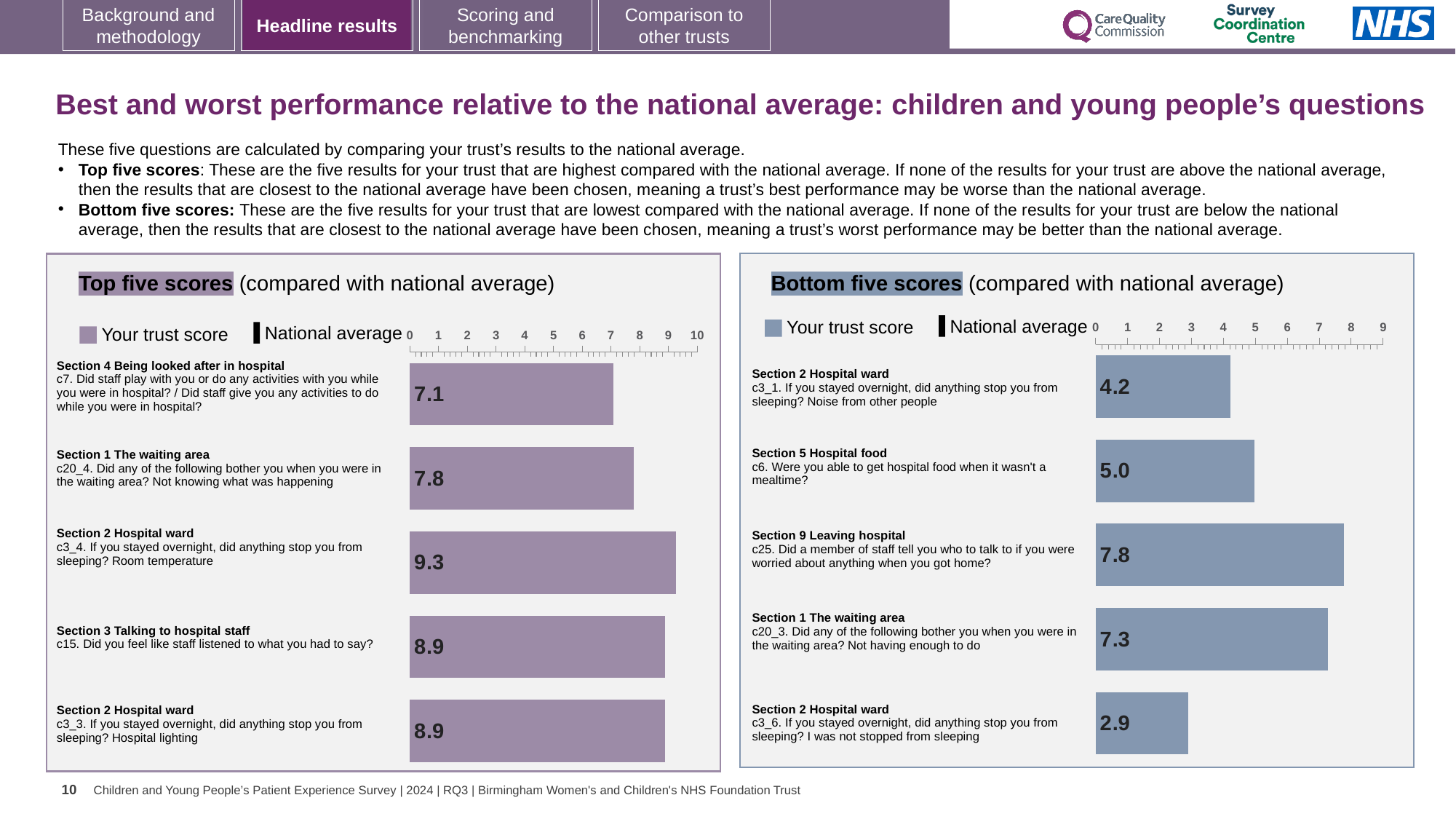
In the Top five scores chart, what is the difference between the trust scores for c3_4 (Room temperature) and c7 (Did staff play with you)? 2.2 In the Bottom five scores chart, which has the larger trust score: c3_1 (Noise from other people) or c6 (hospital food when it wasn't a mealtime)? c6 (hospital food when it wasn't a mealtime) How many questions are shown in the Bottom five scores chart? 5 In the Top five scores chart, which question has the highest trust score? c3_4. If you stayed overnight, did anything stop you from sleeping? Room temperature In the Bottom five scores chart, which question has the highest trust score? c25. Did a member of staff tell you who to talk to if you were worried about anything when you got home? In the Bottom five scores chart, what is the trust score for c6 (Were you able to get hospital food when it wasn't a mealtime?)? 5.0 In the Bottom five scores chart, what is the difference between the trust scores for c20_3 (Not having enough to do) and c3_1 (Noise from other people)? 3.1 What kind of chart is the Top five scores chart? Bar chart In the Top five scores chart, what is the trust score for c7 (Did staff play with you or do any activities with you while you were in hospital?)? 7.1 In the Bottom five scores chart, what is the trust score for c3_6 (I was not stopped from sleeping)? 2.9 In the Bottom five scores chart, which question has the lowest trust score? c3_6. If you stayed overnight, did anything stop you from sleeping? I was not stopped from sleeping In the Top five scores chart, what is the trust score for c3_4 (Room temperature stopping you from sleeping)? 9.3